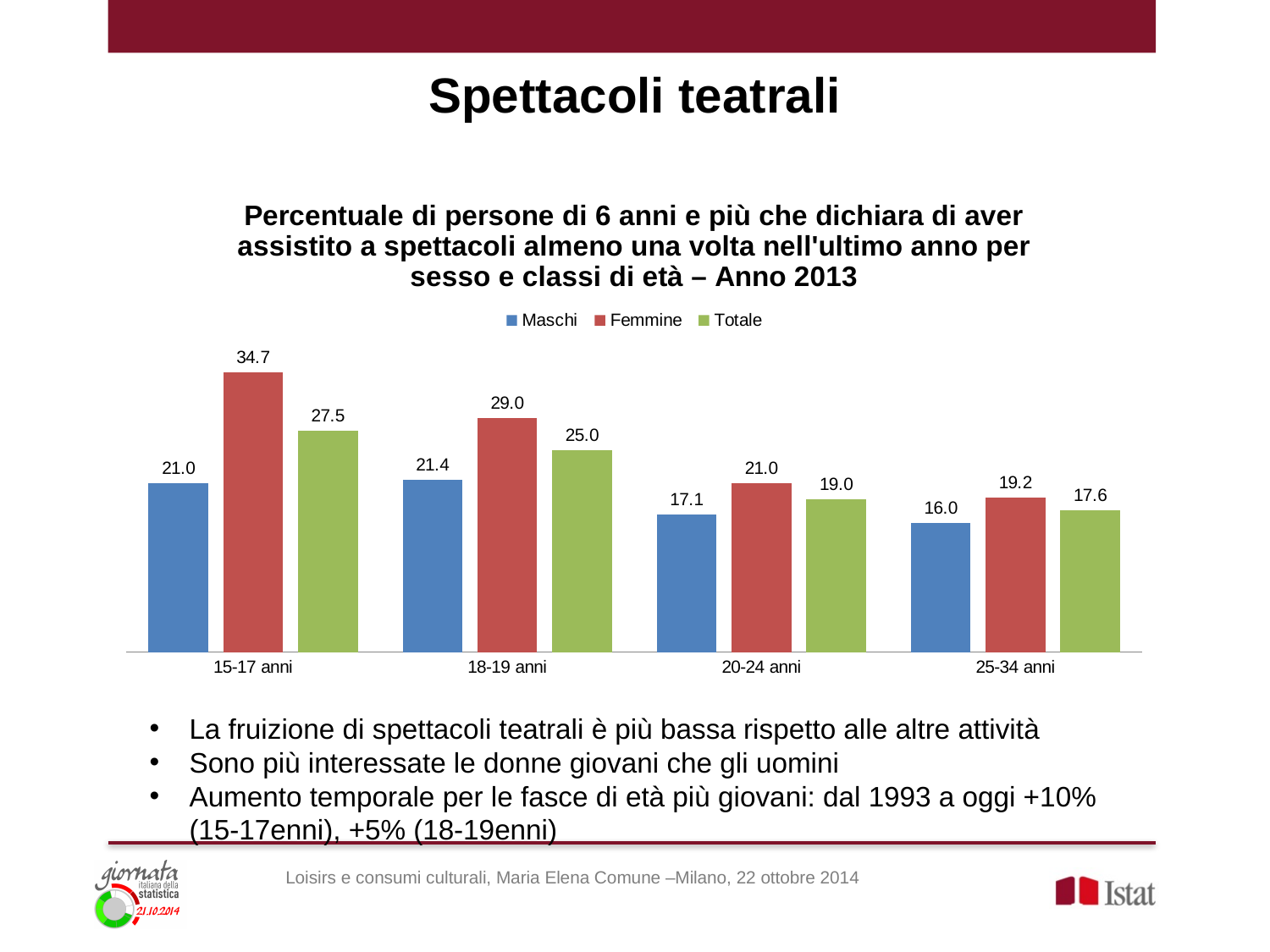
What kind of chart is shown on the slide? Bar chart What is the difference between the Femmine and Maschi values for the 15-17 anni age group? 13.7 Which age group has the lowest Maschi value? 25-34 anni Which is larger: the Maschi value for 15-17 anni or the Maschi value for 18-19 anni? 18-19 anni What is the value for Femmine in the 15-17 anni age group? 34.7 Does the Totale value rise or fall from 15-17 anni to 25-34 anni? Fall What is the Totale value for the 18-19 anni age group? 25.0 Which age group has the highest Femmine value? 15-17 anni What is the value for Maschi in the 25-34 anni age group? 16.0 How many age groups are shown on the x axis? 4 What is the difference between the Totale values for 18-19 anni and 20-24 anni? 6.0 How many series does the legend list? 3